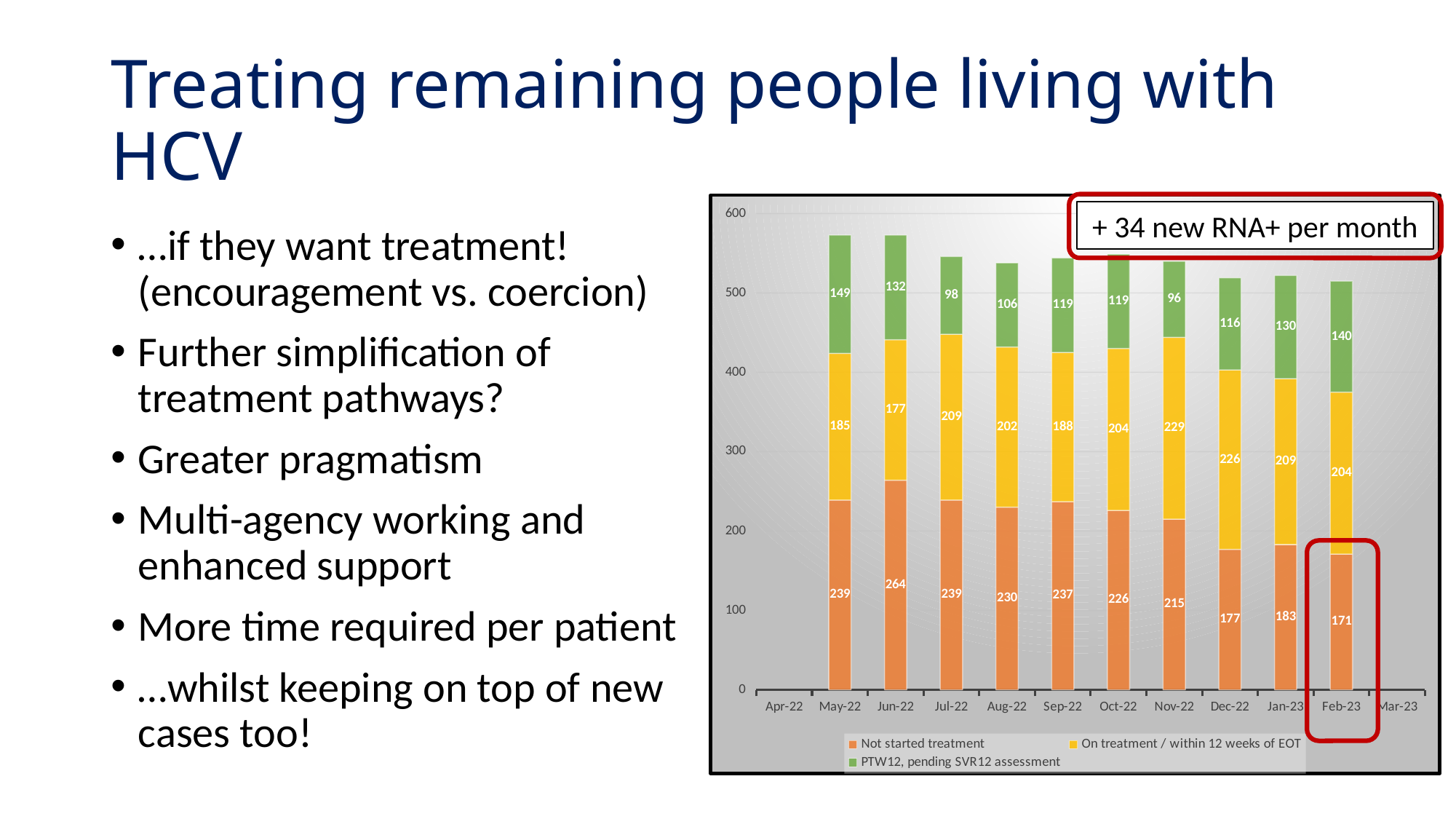
In which month is the Not started treatment value lowest? Feb-23 What is the difference between the Not started treatment values for May-22 and Feb-23? 68 What is the value for PTW12, pending SVR12 assessment in Feb-23? 140 What kind of chart is shown on the slide? Stacked bar chart What is the total of the stacked bar for Feb-23? 515 In which month is the Not started treatment value highest? Jun-22 What does the annotation box at the top right of the chart say? + 34 new RNA+ per month Which is larger, the PTW12, pending SVR12 assessment value for May-22 or for Jul-22? May-22 How many series does the legend list? 3 Does the Not started treatment value rise or fall from May-22 to Feb-23? Fall What is the value for On treatment / within 12 weeks of EOT in Nov-22? 229 What is the value for Not started treatment in Jun-22? 264